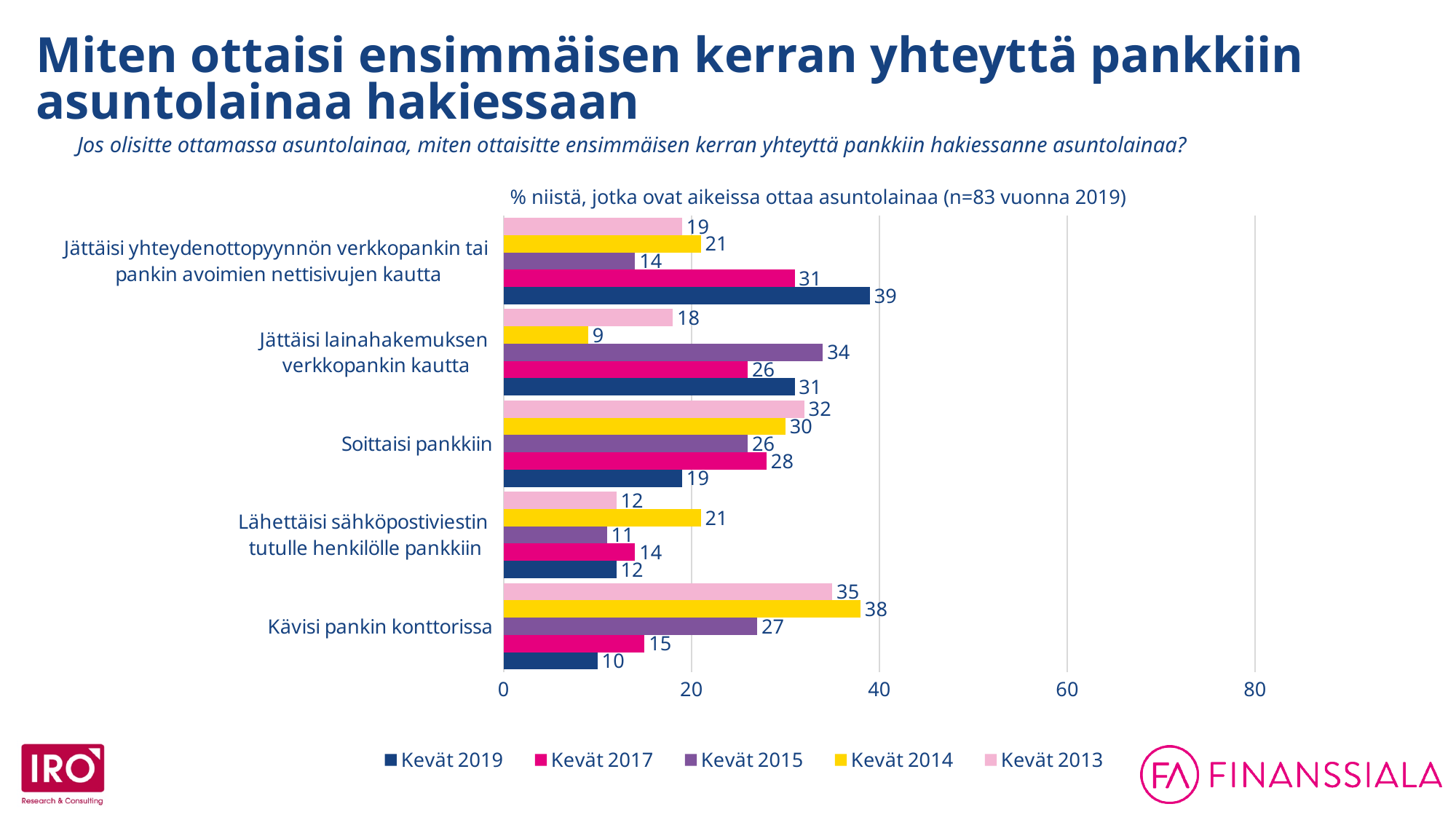
What is the Kevät 2019 value for "Kävisi pankin konttorissa"? 10 What is the difference between the Kevät 2019 and Kevät 2013 values for "Kävisi pankin konttorissa"? 25 What is the Kevät 2013 value for "Soittaisi pankkiin"? 32 What kind of chart is shown on the slide? Bar chart How many series does the legend list? 5 Which series is shown in yellow in the legend? Kevät 2014 How many categories are shown on the y axis? 5 For "Soittaisi pankkiin", which is larger: the Kevät 2017 value or the Kevät 2019 value? Kevät 2017 What is the Kevät 2014 value for "Jättäisi lainahakemuksen verkkopankin kautta"? 9 Which category has the highest Kevät 2019 value? Jättäisi yhteydenottopyynnön verkkopankin tai pankin avoimien nettisivujen kautta What is the difference between the Kevät 2015 and Kevät 2017 values for "Jättäisi lainahakemuksen verkkopankin kautta"? 8 Which category has the lowest Kevät 2014 value? Jättäisi lainahakemuksen verkkopankin kautta